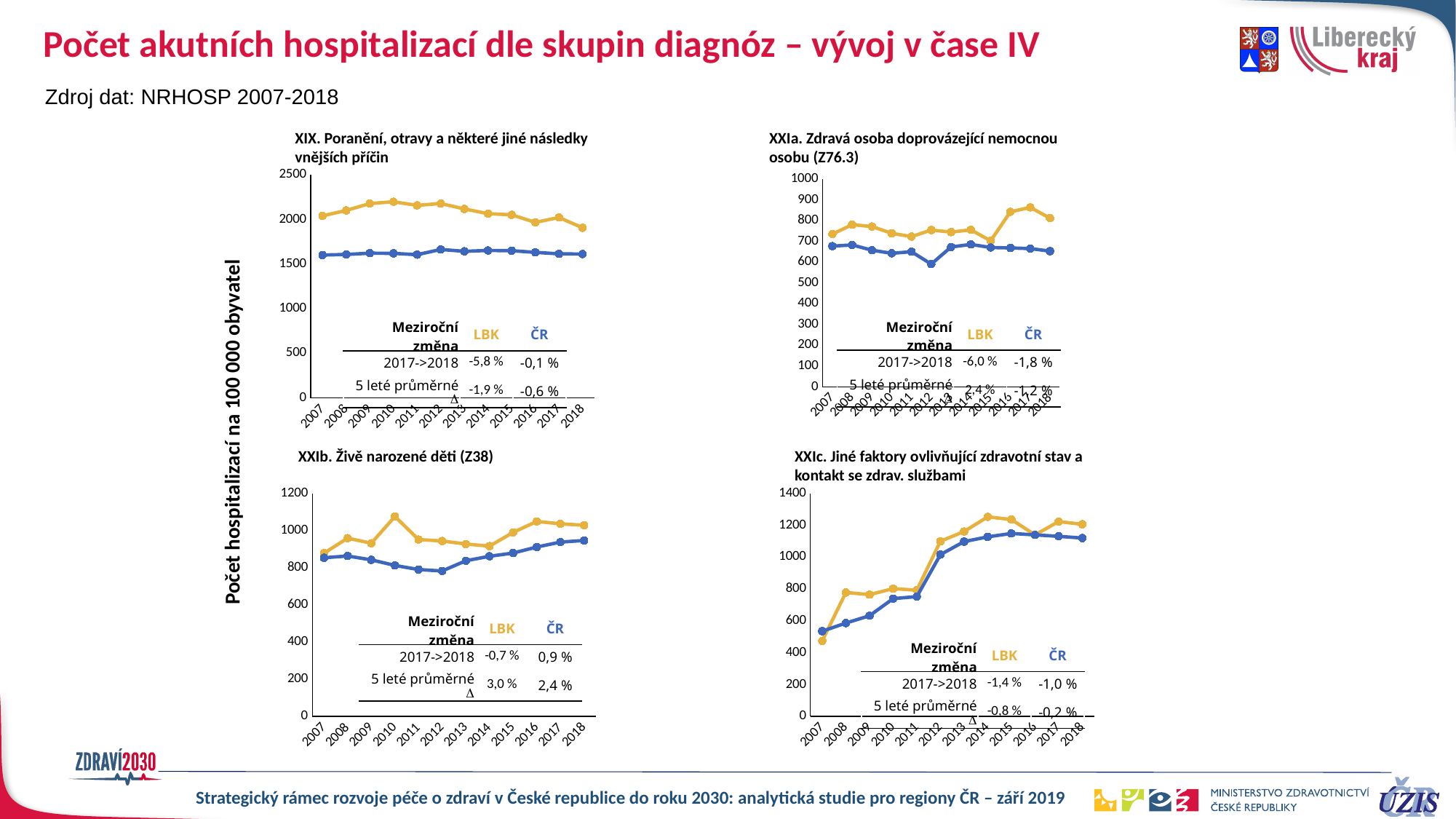
What kind of chart is the top-left chart titled 'XIX. Poranění, otravy a některé jiné následky vnějších příčin'? line chart In the bottom-right chart 'XXIc. Jiné faktory ovlivňující zdravotní stav...', is the LBK value for 2007 greater or less than 600? less In the top-left chart 'XIX. Poranění, otravy...', is the LBK value for 2010 greater or less than 2000? greater In the bottom-right chart 'XXIc. Jiné faktory ovlivňující zdravotní stav...', which series has the larger value in 2007, LBK or ČR? ČR In the top-right chart 'XXIa. Zdravá osoba doprovázející nemocnou osobu (Z76.3)', which year has the highest LBK value? 2017 In the top-left chart 'XIX. Poranění, otravy...', what is the LBK year-on-year change (Meziroční změna) for 2017->2018 shown in the table? -5,8 % In the top-right chart 'XXIa. Zdravá osoba doprovázející nemocnou osobu (Z76.3)', is the ČR value for 2012 greater or less than 700? less In the bottom-left chart 'XXIb. Živě narozené děti (Z38)', what is the 5-year average change (5 leté průměrné Δ) for ČR shown in the table? 2,4 % In the bottom-left chart 'XXIb. Živě narozené děti (Z38)', which year has the highest LBK value? 2010 In the bottom-left chart 'XXIb. Živě narozené děti (Z38)', how many years are plotted along the x axis? 12 In the bottom-right chart 'XXIc. Jiné faktory ovlivňující zdravotní stav...', does the ČR series rise or fall from 2007 to 2018? rise In the top-right chart 'XXIa. Zdravá osoba doprovázející nemocnou osobu (Z76.3)', how many series are plotted? 2